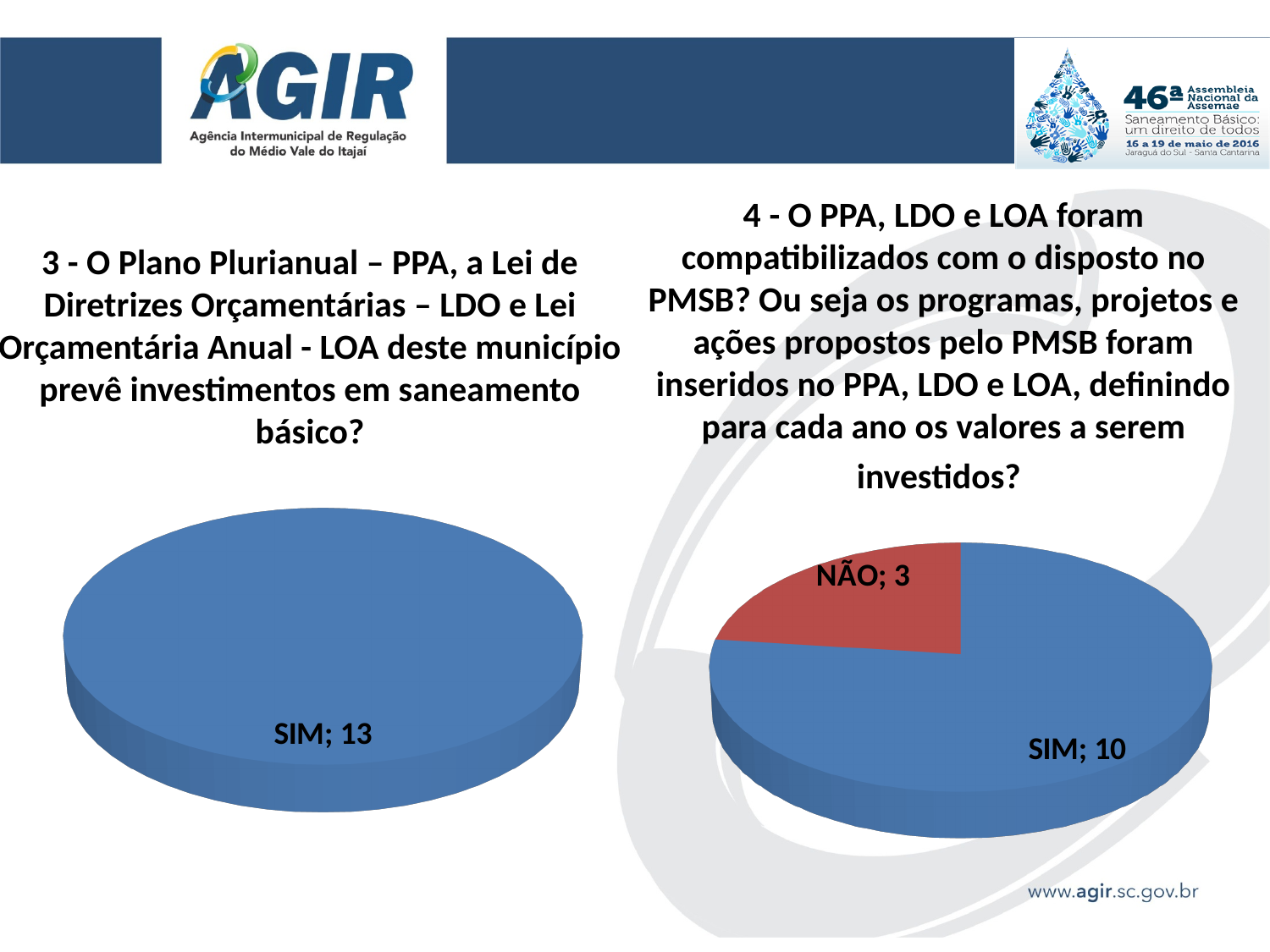
How many slices does the right chart (question 4) have? 2 In the right chart (question 4), what is the total of all slices? 13 In the right chart (question 4), what is the value for NÃO? 3 What type of chart is used on the left side of the slide (question 3)? Pie chart In the right chart (question 4), what is the value for SIM? 10 In the right chart (question 4), what is the difference between the SIM and NÃO values? 7 In the right chart (question 4), which category has the smallest slice? NÃO In the right chart (question 4), which is larger, SIM or NÃO? SIM In the right chart (question 4), what colour is the NÃO slice? Red In the right chart (question 4), which category has the largest slice? SIM In the left chart (question 3), what share of the pie does SIM represent? 100% In the left chart (question 3), what is the value for SIM? 13